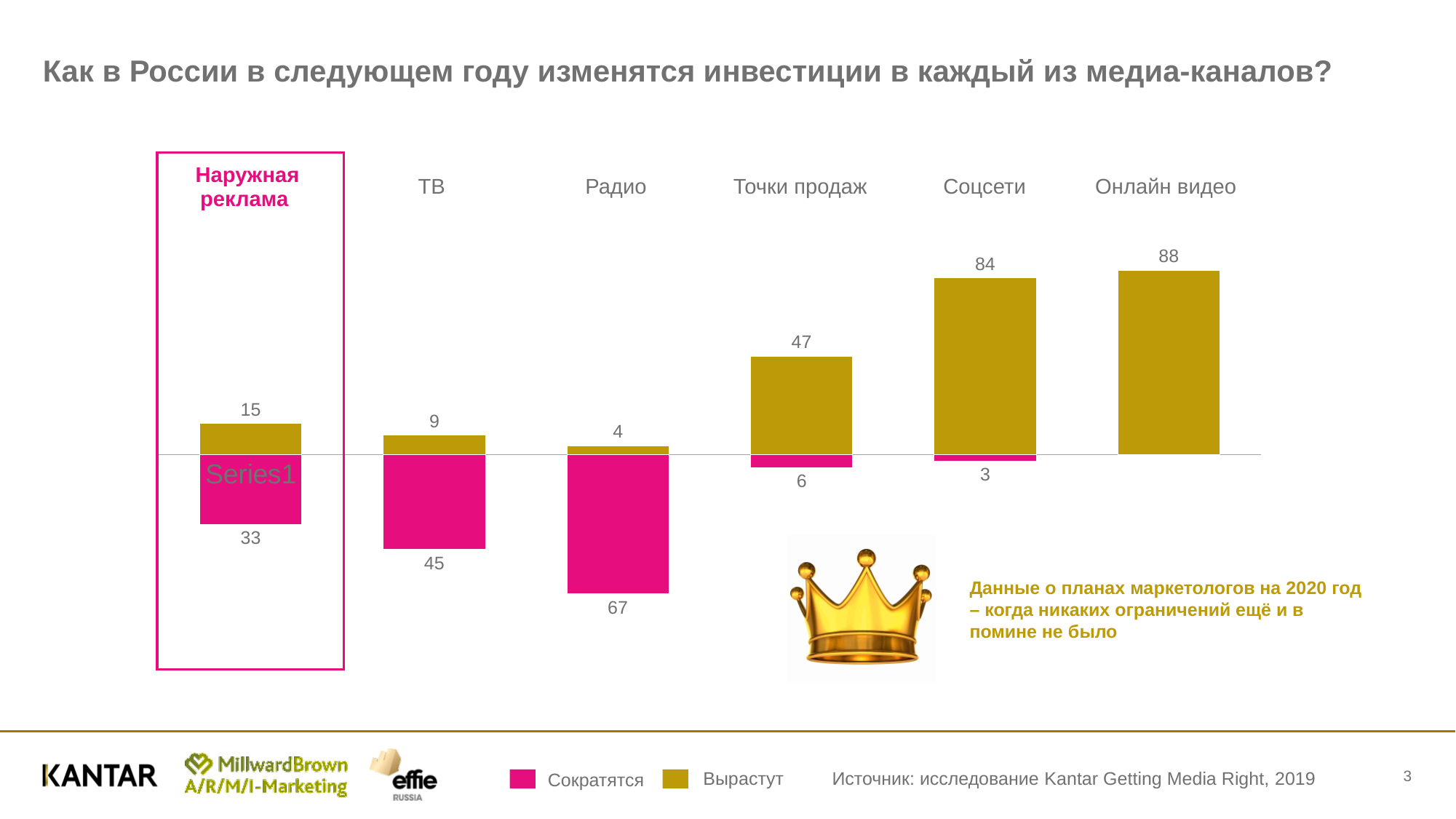
What is the 'Сократятся' value for Радио? 67 How many series does the legend list? 2 What is the 'Вырастут' value for Наружная реклама? 15 What is the difference between the 'Вырастут' values for Соцсети and Точки продаж? 37 What is the 'Сократятся' value for ТВ? 45 How many media channels are shown in the chart? 6 What type of chart is shown on the slide? Bar chart Which is larger: the 'Сократятся' value for Наружная реклама or for ТВ? ТВ What is the 'Вырастут' value for Онлайн видео? 88 Which media channel has the lowest 'Вырастут' value? Радио Which media channel has the highest 'Вырастут' value? Онлайн видео Which media channel has the highest 'Сократятся' value? Радио